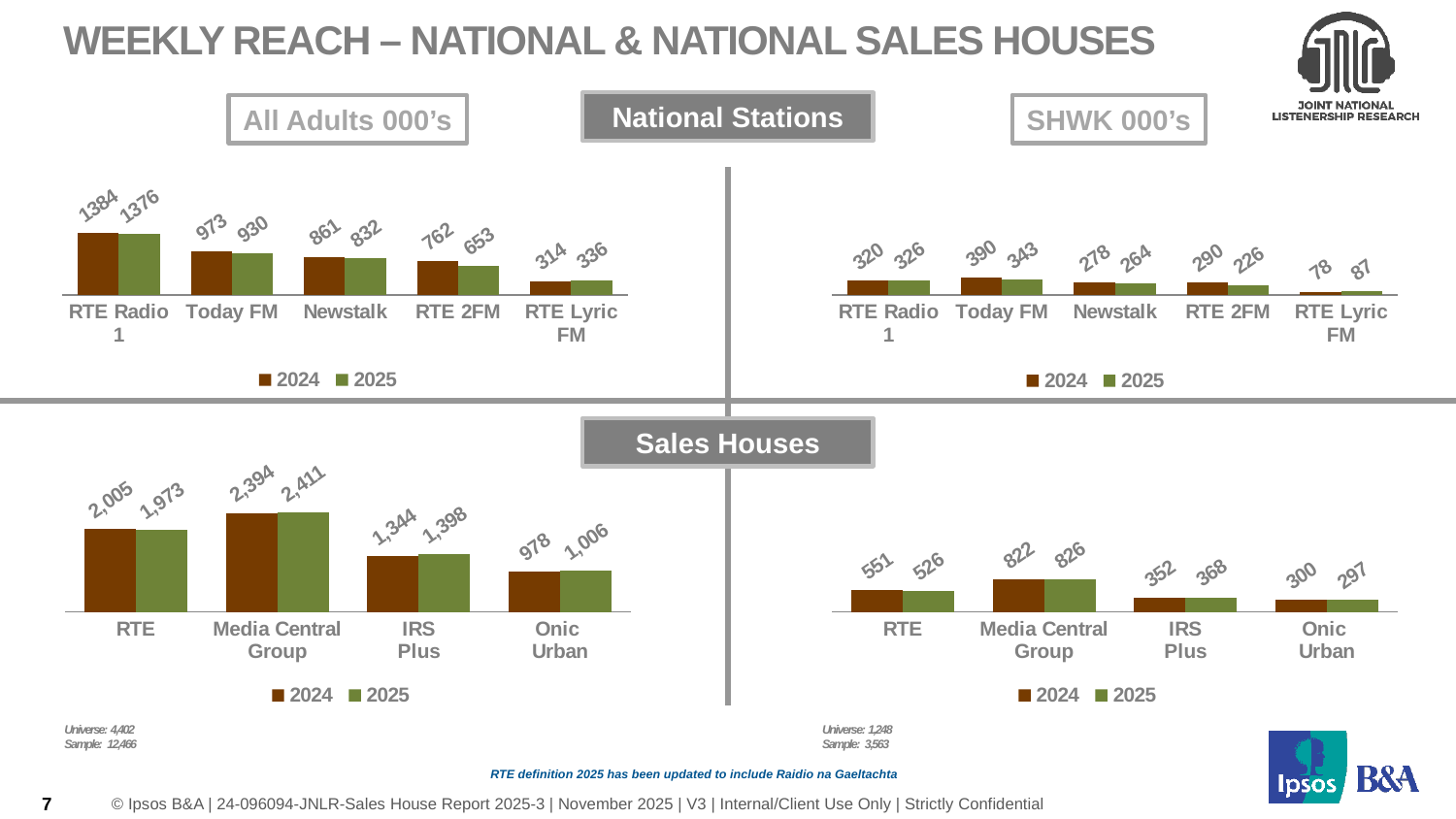
How many series does the legend of the bottom-left chart (All Adults 000's, Sales Houses) list? 2 In the top-left chart (All Adults 000's, National Stations), which station has the lowest 2024 value? RTE Lyric FM In the top-left chart (All Adults 000's, National Stations), what is the difference between the 2024 and 2025 values for RTE 2FM? 109 In the bottom-right chart (SHWK 000's, Sales Houses), what is the difference between the 2024 and 2025 values for RTE? 25 In the top-right chart (SHWK 000's, National Stations), what is the 2025 value for Today FM? 343 In the bottom-left chart (All Adults 000's, Sales Houses), what is the 2025 value for Media Central Group? 2,411 In the top-left chart (All Adults 000's, National Stations), what is the 2025 value for RTE Radio 1? 1376 In the top-right chart (SHWK 000's, National Stations), which station has the highest 2024 value? Today FM In the top-right chart (SHWK 000's, National Stations), is the 2024 value for RTE 2FM larger or the 2025 value? 2024 In the bottom-right chart (SHWK 000's, Sales Houses), what is the 2024 value for IRS Plus? 352 In the top-left chart (All Adults 000's, National Stations), what is the 2024 value for RTE 2FM? 762 In the bottom-left chart (All Adults 000's, Sales Houses), how many sales houses are shown on the x axis? 4